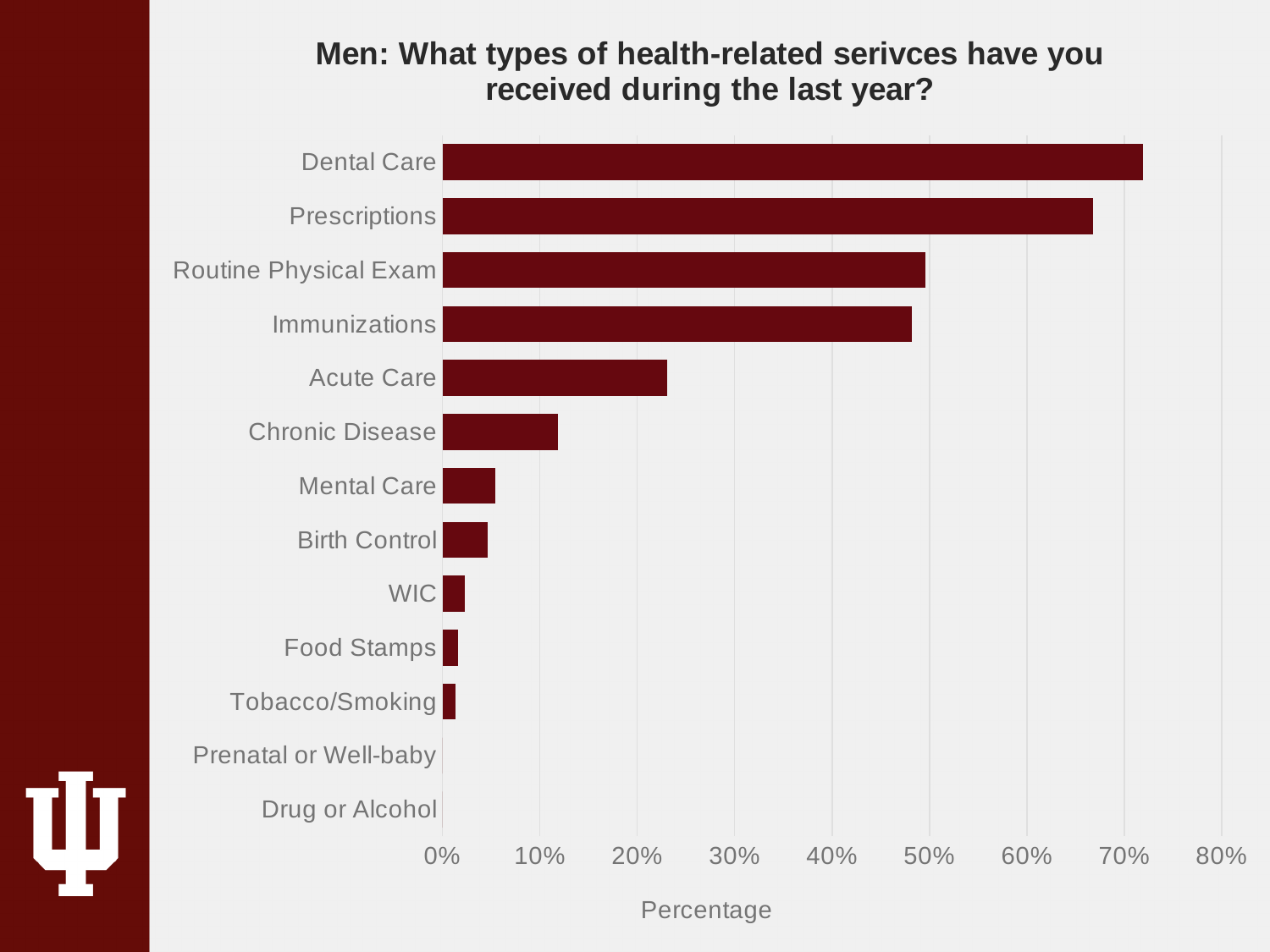
Is the value for Mental Care greater or less than 10%? less Is the value for Acute Care greater or less than 20%? greater What kind of chart is shown on the slide? Bar chart Is the value for Immunizations greater or less than 40%? greater How many health-related service categories are listed on the chart? 13 Which has a higher percentage, Dental Care or Prescriptions? Dental Care Which has a higher percentage, Acute Care or Chronic Disease? Acute Care Which health-related service has the highest percentage? Dental Care Going from the top of the chart to the bottom, do the bar values increase or decrease? Decrease What is the label on the horizontal axis of the chart? Percentage